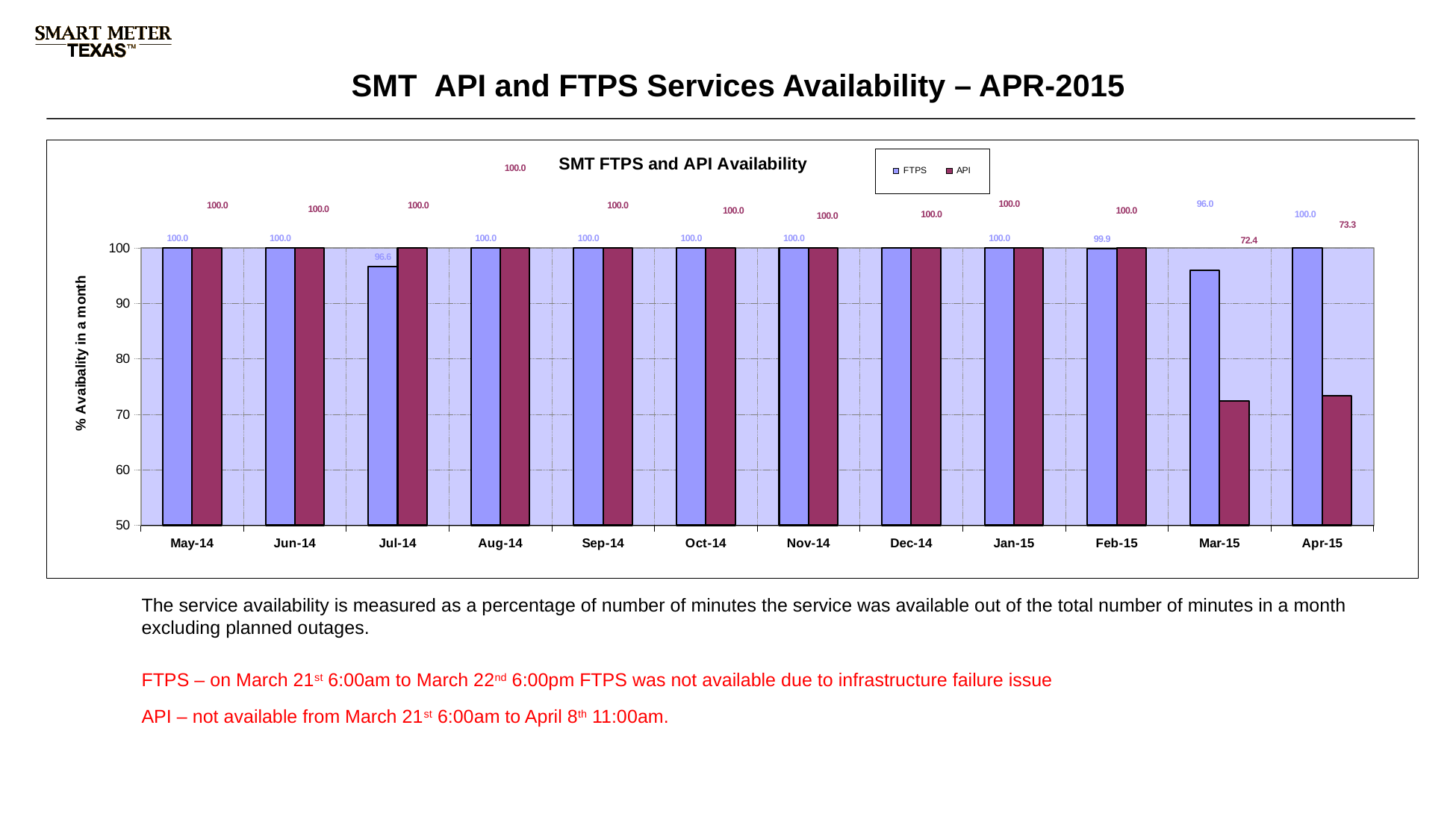
How many months are shown on the x axis? 12 What type of chart is shown? Bar chart In Apr-15, which is larger, the FTPS value or the API value? FTPS How many series does the legend list? 2 What is the difference between the FTPS and API availability values in Mar-15? 23.6 Which month has the lowest API availability? Mar-15 What is the FTPS availability value for Mar-15? 96.0 What is the API availability value for Apr-15? 73.3 What is the API availability value for Mar-15? 72.4 What is the FTPS availability value for Feb-15? 99.9 Which month has the lowest FTPS availability? Mar-15 What is the FTPS availability value for Jul-14? 96.6